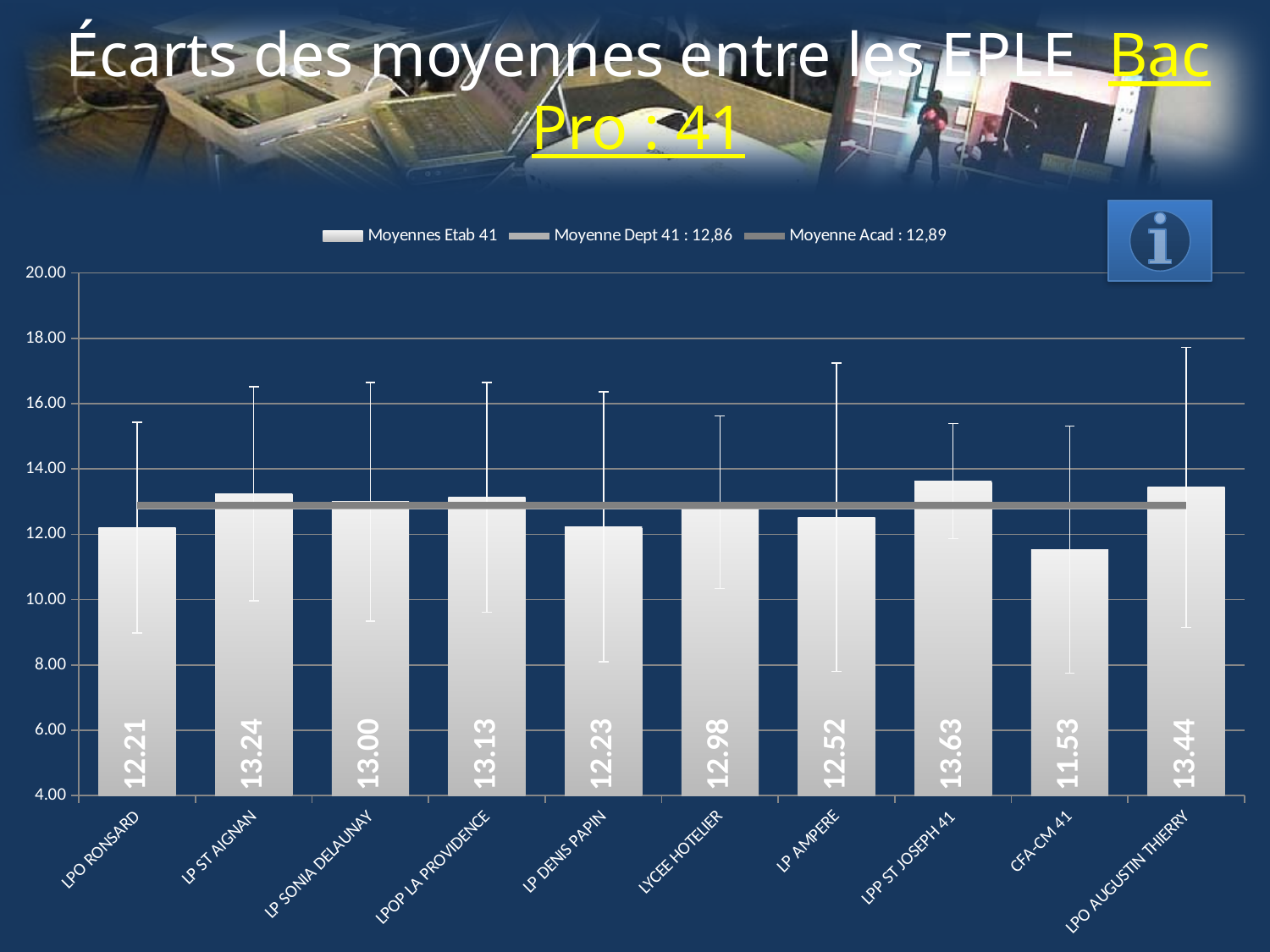
What is the value for LPO RONSARD? 12.21 Which establishment has the highest average? LPP ST JOSEPH 41 Which establishment has the lowest average? CFA-CM 41 Which is larger, the value for LP ST AIGNAN or the value for LP DENIS PAPIN? LP ST AIGNAN What kind of chart is shown on the slide? bar chart Is the value for LPO AUGUSTIN THIERRY greater or less than 12.00? greater How many establishments are shown on the x axis? 10 What is the value for LYCEE HOTELIER? 12.98 What is the value for LPP ST JOSEPH 41? 13.63 What is the value for CFA-CM 41? 11.53 What is the difference between the values for LPP ST JOSEPH 41 and CFA-CM 41? 2.10 How many series does the legend list? 3